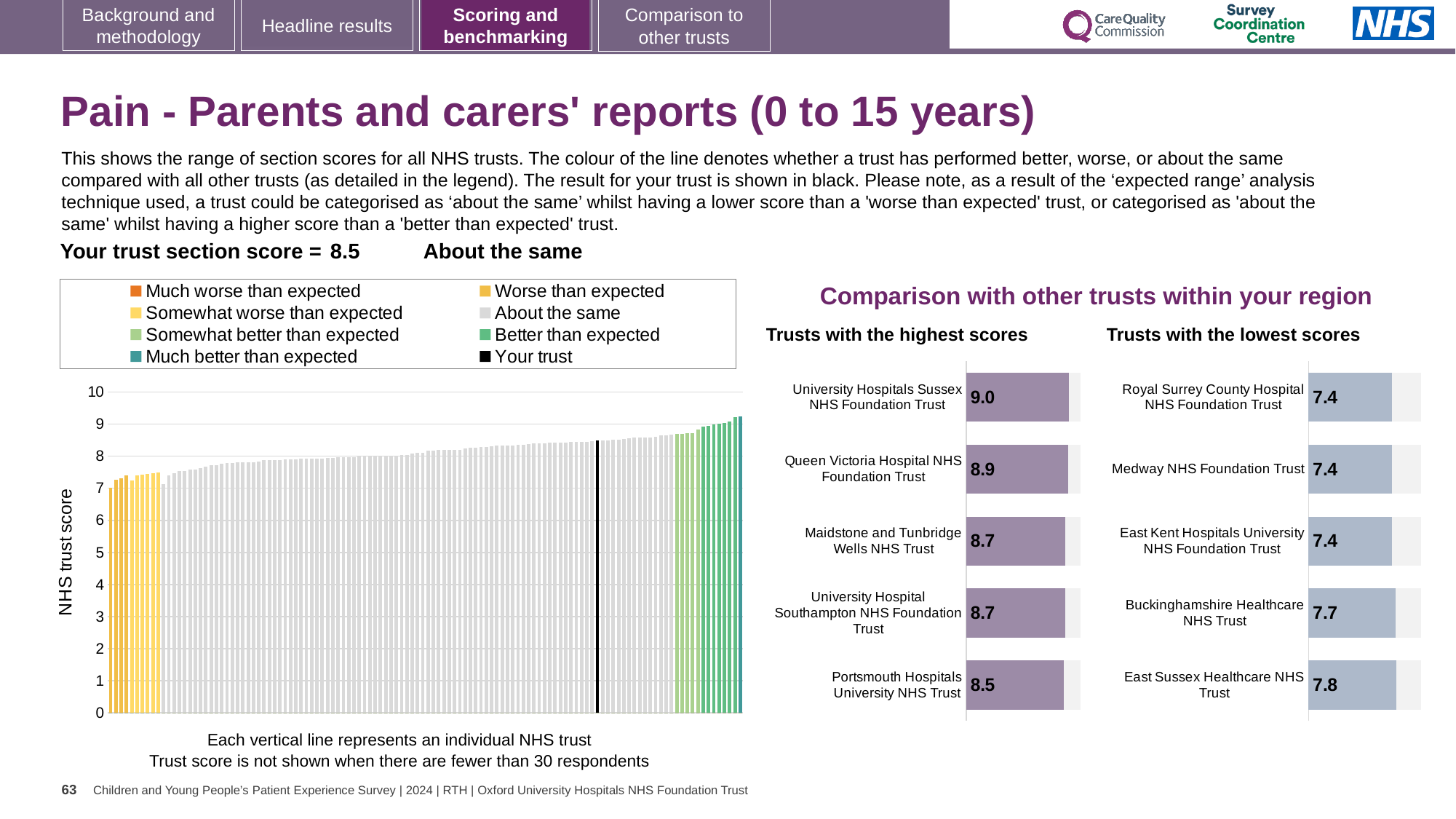
In the 'Trusts with the lowest scores' chart, what is the difference between the scores of East Sussex Healthcare NHS Trust and Medway NHS Foundation Trust? 0.4 How many entries does the legend above the large chart on the left list? 8 What kind of chart is the large chart on the left showing NHS trust scores? Bar chart In the 'Trusts with the highest scores' chart, which trust has the highest score? University Hospitals Sussex NHS Foundation Trust In the 'Trusts with the lowest scores' chart, which trust has the highest score? East Sussex Healthcare NHS Trust How many trusts are shown in the 'Trusts with the highest scores' chart? 5 In the 'Trusts with the lowest scores' chart, which has the larger score: Buckinghamshire Healthcare NHS Trust or East Sussex Healthcare NHS Trust? East Sussex Healthcare NHS Trust In the 'Trusts with the highest scores' chart, what is the score for Portsmouth Hospitals University NHS Trust? 8.5 In the large chart on the left, is the value for the black bar (your trust) greater or less than 8? greater In the 'Trusts with the lowest scores' chart, what is the score for Buckinghamshire Healthcare NHS Trust? 7.7 In the 'Trusts with the highest scores' chart, what is the difference between the scores of University Hospitals Sussex NHS Foundation Trust and Portsmouth Hospitals University NHS Trust? 0.5 In the 'Trusts with the highest scores' chart, what is the score for University Hospitals Sussex NHS Foundation Trust? 9.0